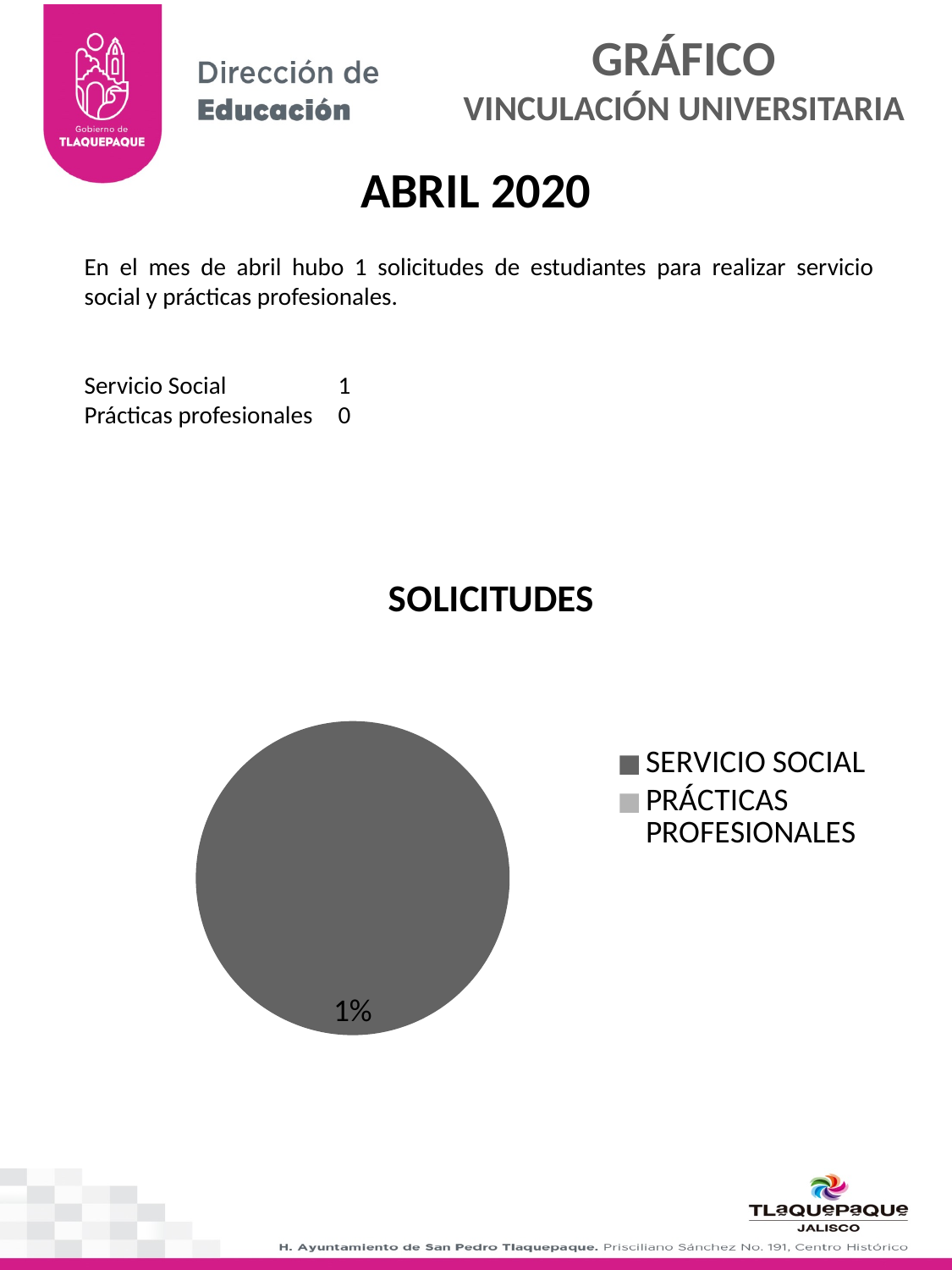
According to the slide, how many Prácticas profesionales requests were there in April 2020? 0 Which category occupies the largest share of the pie? SERVICIO SOCIAL Which category has the smallest share of the pie? PRÁCTICAS PROFESIONALES What kind of chart is shown on the slide? pie chart How many entries does the chart legend list? 2 What is the difference between the number of Servicio Social requests and Prácticas profesionales requests shown on the slide? 1 What colour is the legend marker for SERVICIO SOCIAL? dark gray What is the title of the chart? SOLICITUDES According to the slide, how many Servicio Social requests were there in April 2020? 1 Which is larger in the pie chart, SERVICIO SOCIAL or PRÁCTICAS PROFESIONALES? SERVICIO SOCIAL What data label is printed on the pie slice? 1%